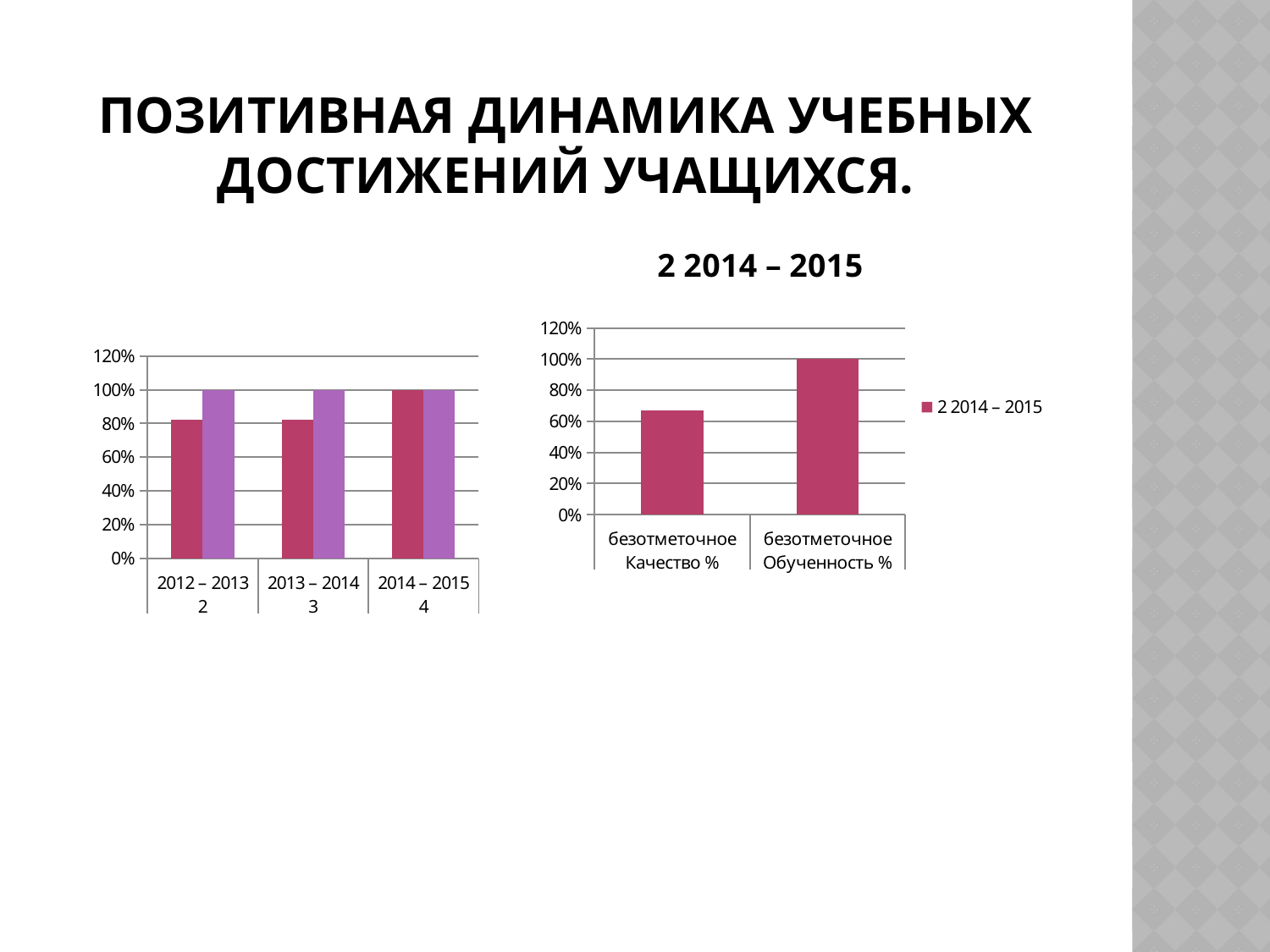
On the right chart titled "2 2014 – 2015", how many series does the legend list? 1 On the right chart titled "2 2014 – 2015", is the value for безотметочное Качество % greater or less than 80%? less On the right chart titled "2 2014 – 2015", how many categories are shown? 2 On the right chart titled "2 2014 – 2015", what is the value for безотметочное Обученность %? 100% On the left chart, in which category is the red bar highest? 2014 – 2015 4 On the left chart, do the red bars rise or fall from 2013 – 2014 3 to 2014 – 2015 4? rise On the left chart, how many categories are shown on the x axis? 3 On the right chart titled "2 2014 – 2015", is the value for безотметочное Качество % greater or less than 60%? greater On the left chart, is the red bar for 2012 – 2013 2 greater or less than 100%? less On the left chart, what is the value of the purple bar for 2014 – 2015 4? 100% What kind of chart is the chart on the left of the slide? bar chart On the right chart titled "2 2014 – 2015", which category has the higher value? безотметочное Обученность %